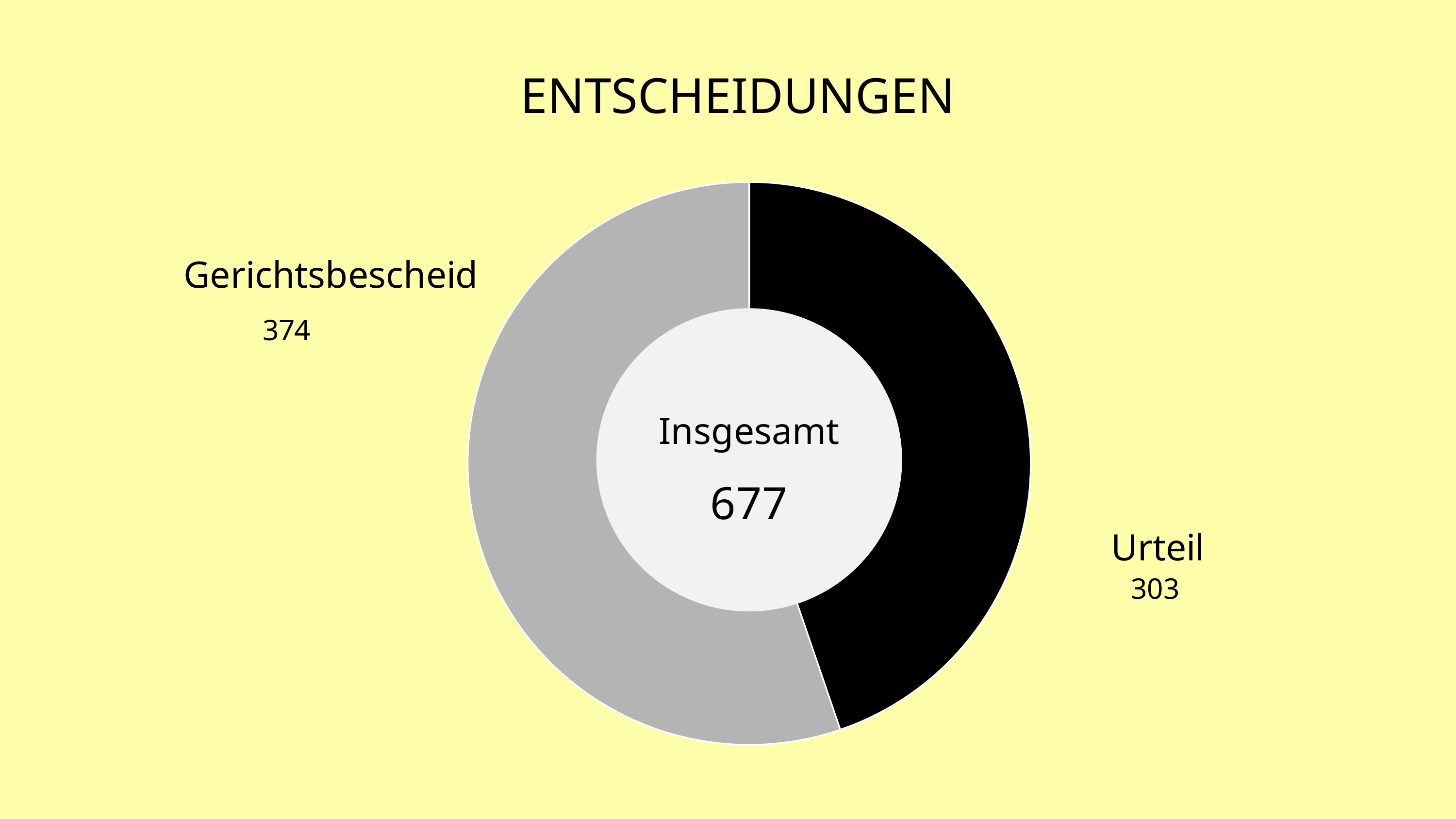
What is the total shown in the centre of the chart? 677 What kind of chart is shown on the slide? Doughnut chart Which is larger, Gerichtsbescheid or Urteil? Gerichtsbescheid What is the value for Gerichtsbescheid? 374 Which category has the highest value? Gerichtsbescheid How many categories does the chart show? 2 Which category has the lowest value? Urteil What colour is the Urteil segment? Black What is the title of the chart? ENTSCHEIDUNGEN What is the value for Urteil? 303 What is the difference between the values for Gerichtsbescheid and Urteil? 71